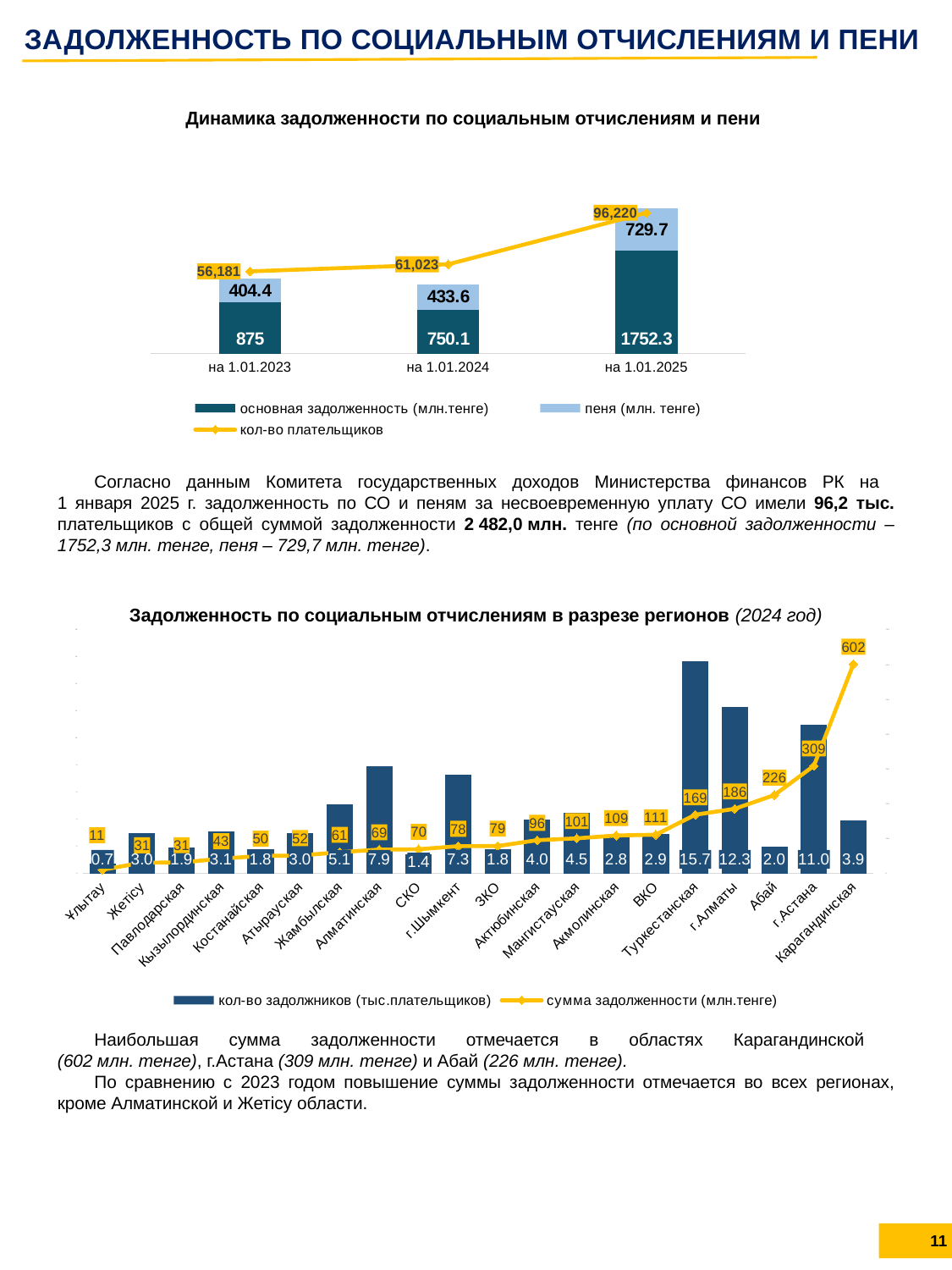
In the chart 'Динамика задолженности по социальным отчислениям и пени', what is the основная задолженность (млн.тенге) на 1.01.2025? 1752.3 In the chart 'Динамика задолженности по социальным отчислениям и пени', how many series does the legend list? 3 In the chart 'Задолженность по социальным отчислениям в разрезе регионов (2024 год)', what is the difference in сумма задолженности (млн.тенге) between Карагандинская and г.Астана? 293 In the chart 'Динамика задолженности по социальным отчислениям и пени', does the кол-во плательщиков rise or fall from 1.01.2023 to 1.01.2025? rise In the chart 'Задолженность по социальным отчислениям в разрезе регионов (2024 год)', how many regions are shown on the x axis? 20 In the chart 'Динамика задолженности по социальным отчислениям и пени', what is the кол-во плательщиков на 1.01.2023? 56,181 In the chart 'Динамика задолженности по социальным отчислениям и пени', what is the пеня (млн. тенге) на 1.01.2024? 433.6 In the chart 'Задолженность по социальным отчислениям в разрезе регионов (2024 год)', which region has the lowest кол-во задолжников (тыс.плательщиков)? Ұлытау In the chart 'Задолженность по социальным отчислениям в разрезе регионов (2024 год)', what is the сумма задолженности (млн.тенге) for Абай? 226 In the chart 'Динамика задолженности по социальным отчислениям и пени', what is the total of the stacked bar на 1.01.2025 (основная задолженность plus пеня)? 2482.0 In the chart 'Задолженность по социальным отчислениям в разрезе регионов (2024 год)', which region has the highest сумма задолженности (млн.тенге)? Карагандинская In the chart 'Задолженность по социальным отчислениям в разрезе регионов (2024 год)', what is the кол-во задолжников (тыс.плательщиков) for Туркестанская? 15.7